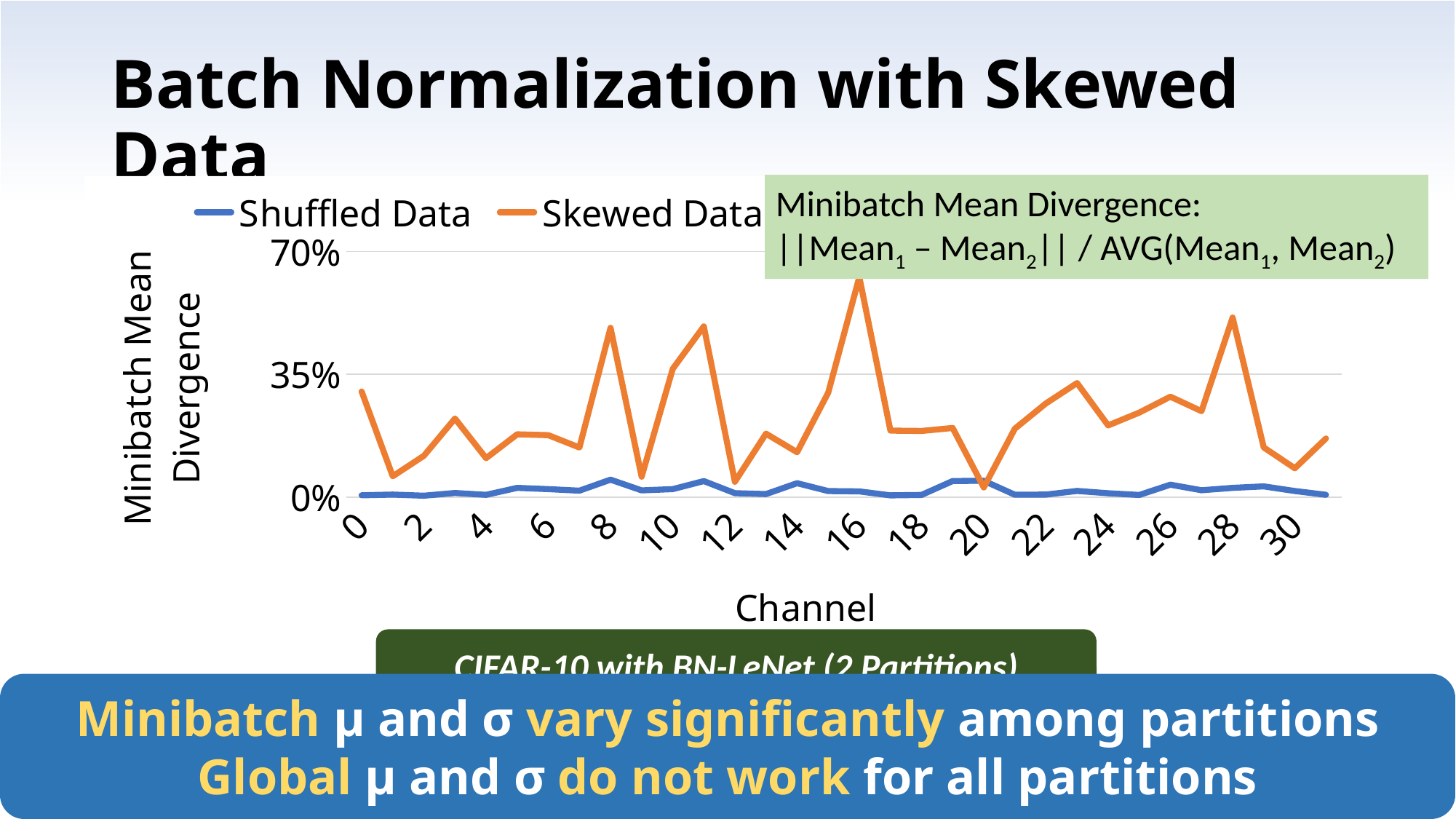
Is the Shuffled Data value at channel 8 greater or less than 35%? less Is the Skewed Data value at channel 28 greater or less than 35%? greater Is the Skewed Data value at channel 16 greater or less than 35%? greater How many series does the chart's legend list? 2 What is the label of the x axis? Channel Which series is larger at channel 28, Shuffled Data or Skewed Data? Skewed Data What kind of chart is shown on the slide? line chart What are the two series named in the legend? Shuffled Data and Skewed Data Which series has the highest value at channel 16, Shuffled Data or Skewed Data? Skewed Data At which channel does the Skewed Data series reach its highest value? 16